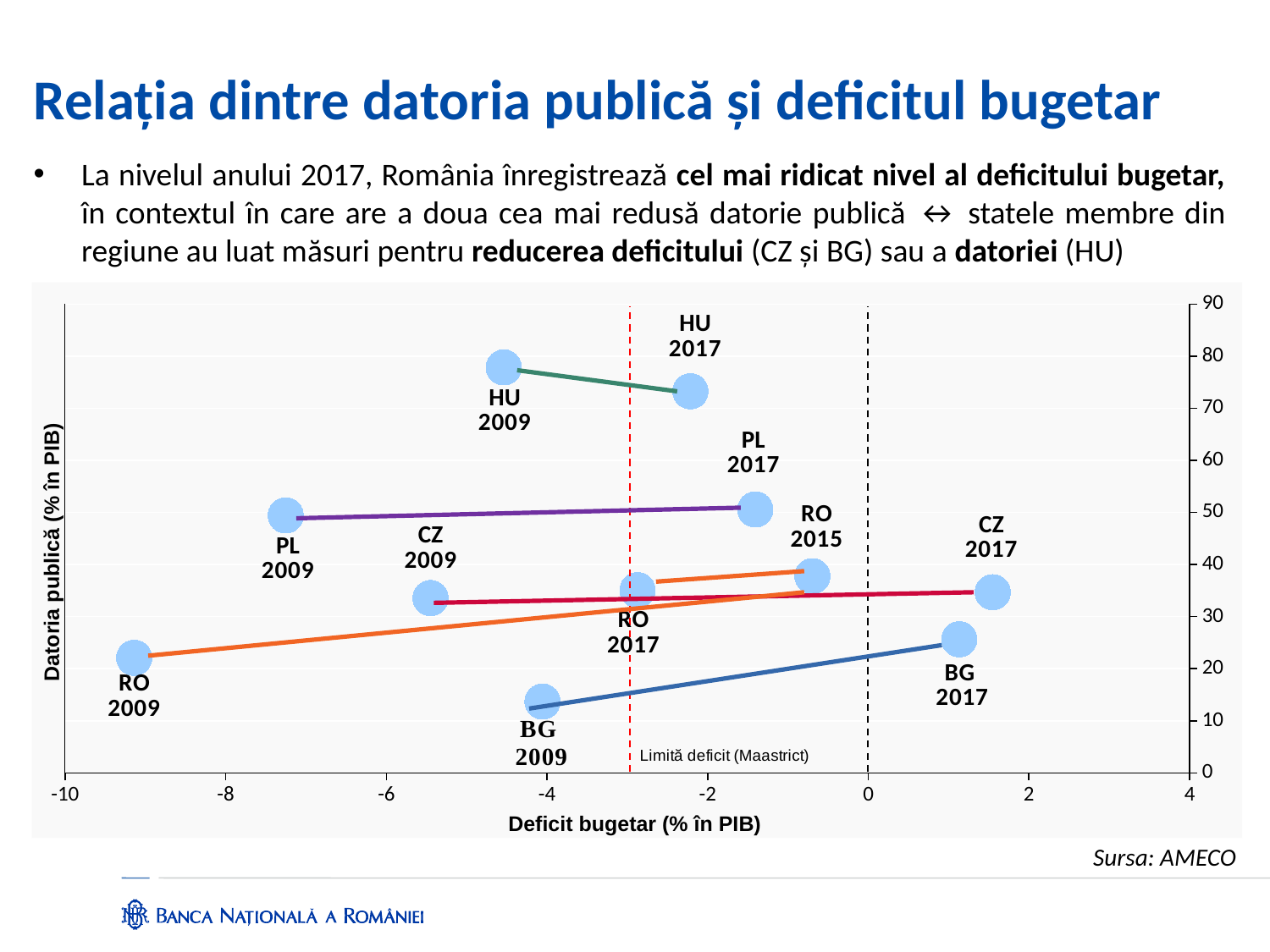
What is the title of the x axis? Deficit bugetar (% în PIB) What kind of chart is shown on the slide? scatter chart Is the budget deficit value for CZ 2017 greater or less than 0? greater What does the red dashed vertical line represent, according to its label? Limită deficit (Maastrict) Which labelled point has the lowest public debt (Datoria publică)? BG 2009 Which has the higher public debt, HU 2017 or PL 2017? HU 2017 How many labelled data points are plotted on the chart? 11 Is the public debt value for PL 2017 greater or less than 40? greater Which labelled point has the most negative budget deficit (furthest left on the x axis)? RO 2009 Which labelled point has the highest public debt (Datoria publică)? HU 2009 Is the public debt value for HU 2009 greater or less than 70? greater